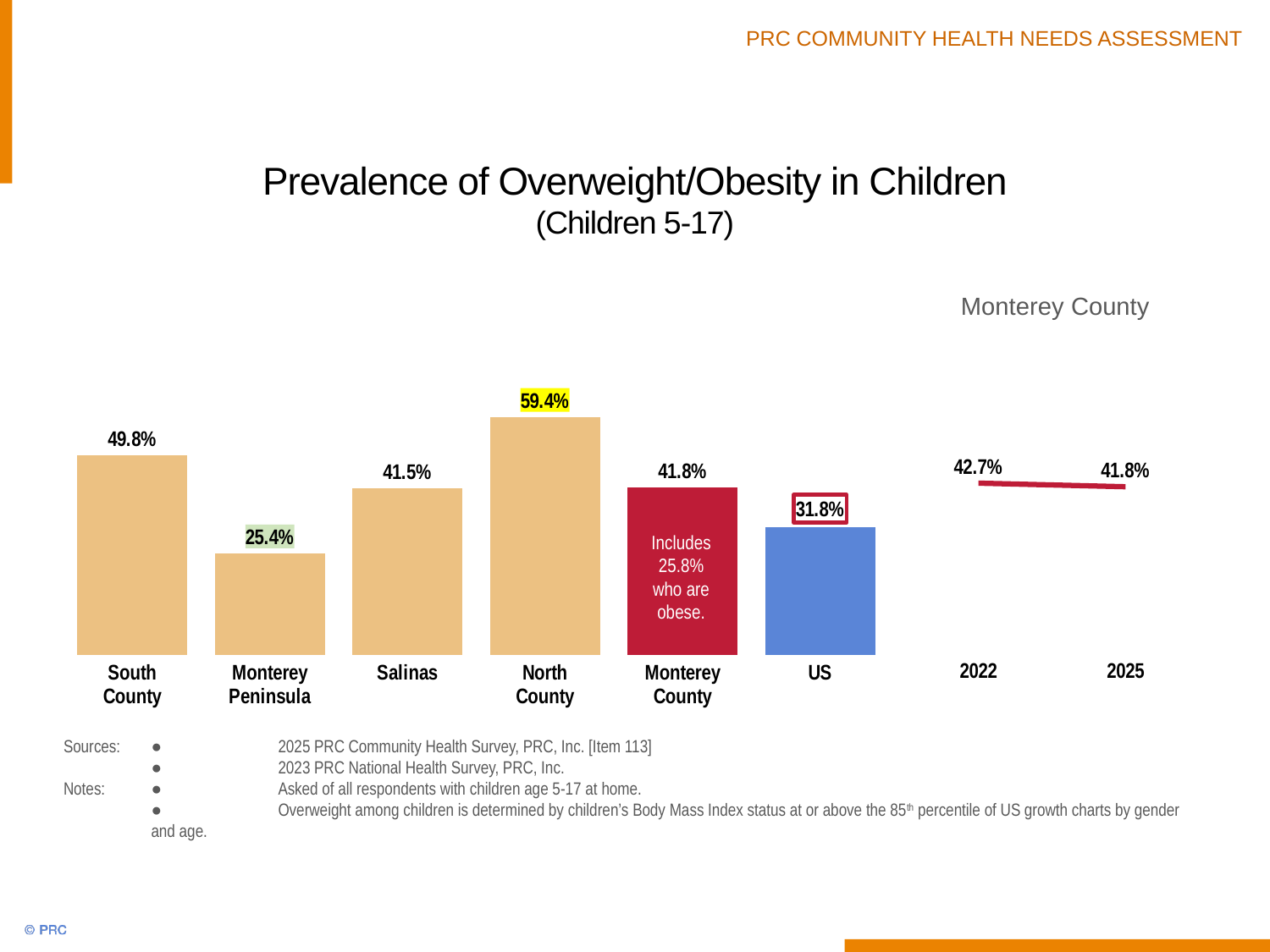
What kind of chart is used to show the values for South County, Monterey Peninsula, Salinas, North County, Monterey County and US? Bar chart What is the prevalence of overweight/obesity in children for North County? 59.4% Which is larger, the value for Monterey County or the value for the US? Monterey County According to the label inside the Monterey County bar, what percentage of children are obese? 25.8% How many bars are shown in the bar chart? 6 What is the difference between the South County value and the Salinas value? 8.3% Which area has the lowest prevalence of overweight/obesity in children in the bar chart? Monterey Peninsula What is the value shown for Monterey Peninsula? 25.4% Which area has the highest prevalence of overweight/obesity in children in the bar chart? North County What is the value shown for the US in the bar chart? 31.8% In the trend chart on the right, did the value rise or fall from 2022 to 2025? Fall In the trend chart on the right, what was the Monterey County value in 2022? 42.7%